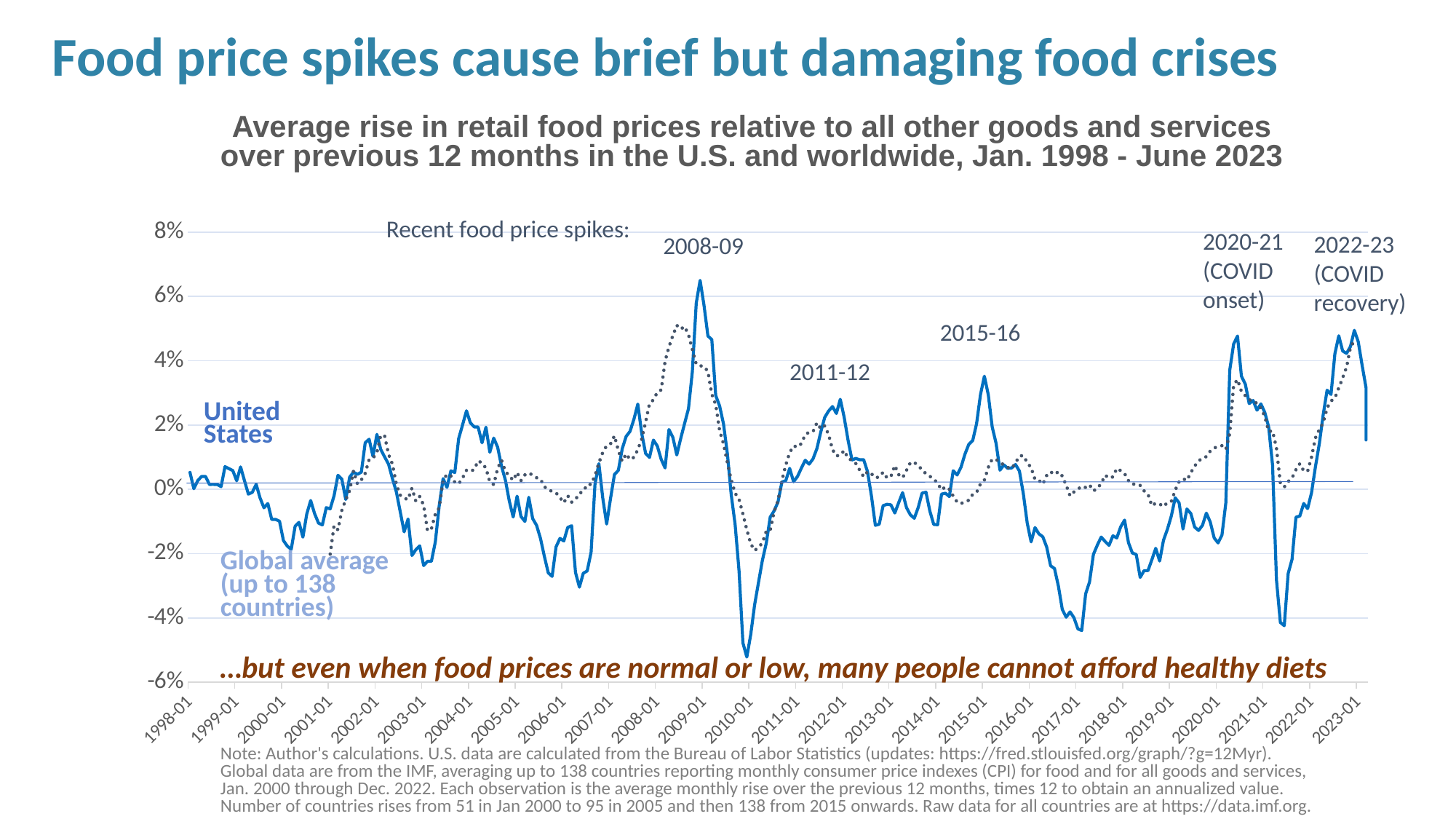
Is the United States value at its lowest point around 2010-01 greater or less than -4%? less At the 2008-09 peak, which series reaches the higher value, United States or Global average? United States Which series is drawn as a dotted line? Global average (up to 138 countries) Does the United States line rise or fall between 2010-01 and 2012-01? rise Which of the labelled food price spikes shows the highest United States value? 2008-09 What kind of chart is shown on the slide? line chart Is the United States value at its 2008-09 peak greater or less than 6%? greater Is the Global average value at its 2008 peak greater or less than 4%? greater How many series are plotted on the chart? 2 How many recent food price spikes are labelled on the chart? 5 Which two series are plotted on the chart? United States and Global average (up to 138 countries)